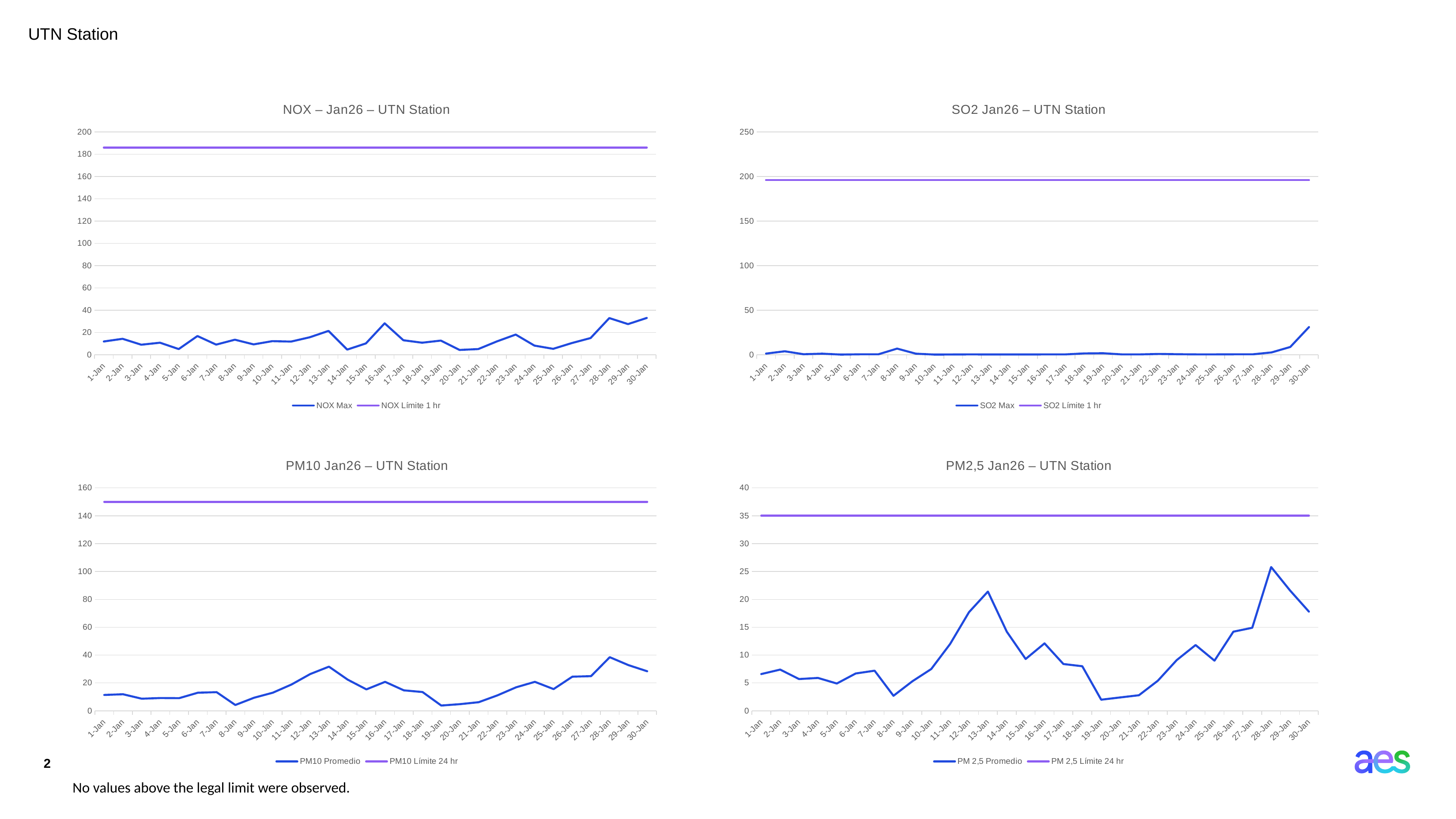
In the SO2 Jan26 – UTN Station chart, on which date is SO2 Max highest? 30-Jan In the PM2,5 Jan26 – UTN Station chart, is the PM 2,5 Promedio value on 28-Jan greater or less than 25? greater How many series does the legend of the PM2,5 Jan26 – UTN Station chart list? 2 In the PM10 Jan26 – UTN Station chart, is the PM10 Promedio value on 13-Jan greater or less than 20? greater In the SO2 Jan26 – UTN Station chart, what are the two legend entries? SO2 Max and SO2 Límite 1 hr In the PM10 Jan26 – UTN Station chart, on which date is PM10 Promedio highest? 28-Jan What kind of chart is the NOX – Jan26 – UTN Station chart? line chart In the PM2,5 Jan26 – UTN Station chart, which date has the larger PM 2,5 Promedio value, 13-Jan or 28-Jan? 28-Jan In the PM2,5 Jan26 – UTN Station chart, what is the value of the PM 2,5 Límite 24 hr line? 35 How many dates are plotted along the x axis of the PM10 Jan26 – UTN Station chart? 30 In the NOX – Jan26 – UTN Station chart, is the NOX Max value on 16-Jan greater or less than 20? greater In the PM2,5 Jan26 – UTN Station chart, on which date is PM 2,5 Promedio highest? 28-Jan